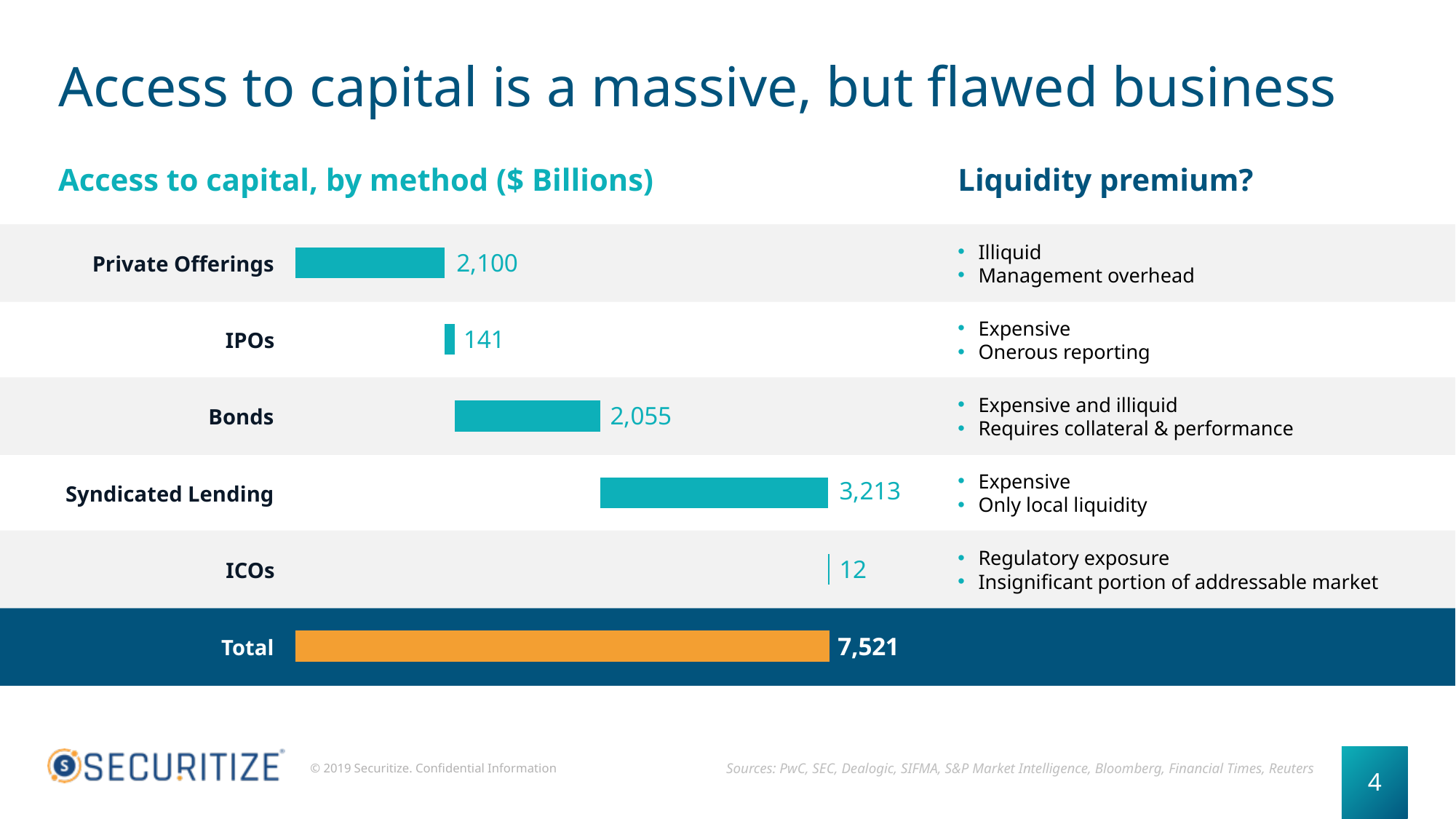
What kind of chart is used to show access to capital by method? Bar chart What is the value for IPOs? 141 Which is larger, Private Offerings or Bonds? Private Offerings What is the value for Private Offerings in the 'Access to capital, by method' chart? 2,100 How many methods are shown in the chart, excluding the Total row? 5 What is the value for Syndicated Lending? 3,213 What is the value for ICOs? 12 Which method has the lowest value? ICOs Which method has the highest value? Syndicated Lending What is the difference between Private Offerings and Bonds? 45 What is the difference between Syndicated Lending and Private Offerings? 1,113 What is the Total value shown at the bottom of the chart? 7,521